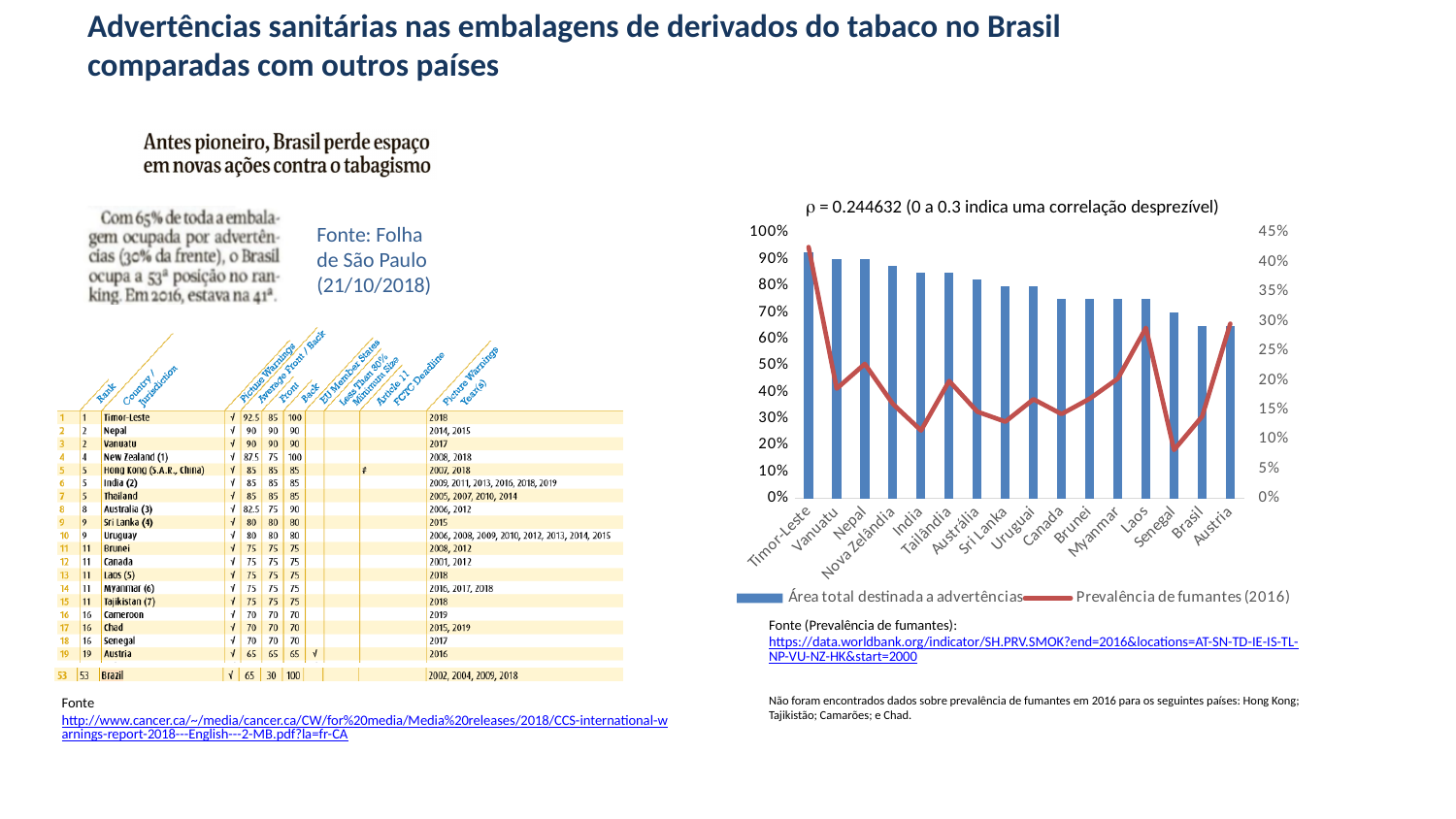
What kind of chart is shown on the right side of the slide? A combined bar and line chart What correlation coefficient value is given in the title of the chart? ρ = 0.244632 Do the 'Área total destinada a advertências' bars rise or fall from left to right along the x axis? fall How many countries are shown along the x axis of the chart? 16 Is the 'Prevalência de fumantes (2016)' value for Senegal greater or less than 10%? less Which country has the highest value on the 'Prevalência de fumantes (2016)' line? Timor-Leste Which country has the lowest value on the 'Prevalência de fumantes (2016)' line? Senegal Which country has the highest bar for 'Área total destinada a advertências'? Timor-Leste How many series does the legend of the chart list? 2 Is the 'Área total destinada a advertências' bar for Brasil greater or less than 70%? less Is the 'Área total destinada a advertências' bar for Timor-Leste greater or less than 80%? greater Which has the larger 'Área total destinada a advertências' bar, Timor-Leste or Brasil? Timor-Leste